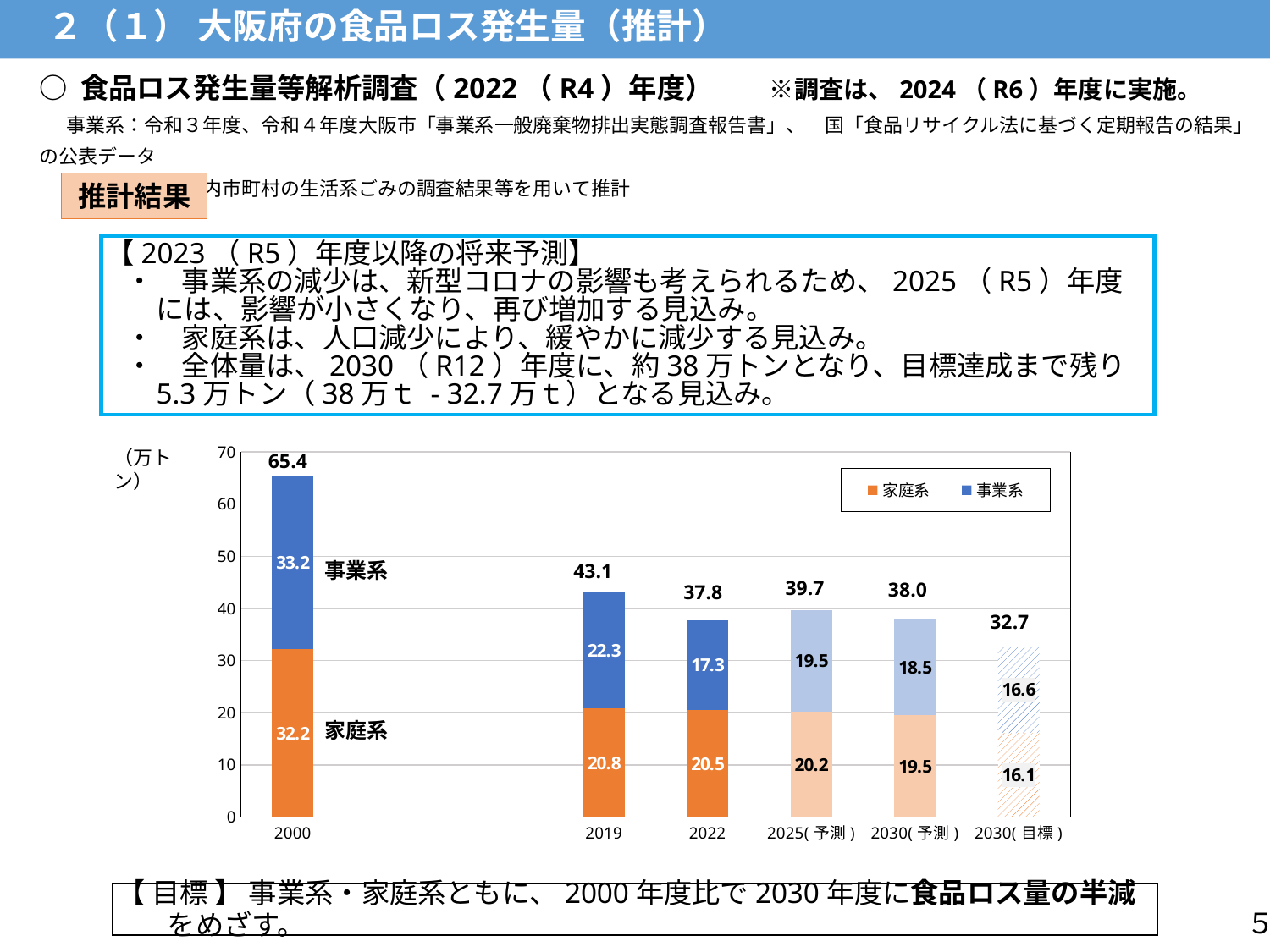
What type of chart is shown on the slide? Stacked bar chart What is the difference between the 事業系 value for 2000 and the 事業系 value for 2019? 10.9 Which category has the lowest total value? 2030(目標) How many categories are shown on the x axis of the chart? 6 Which is larger, the 家庭系 value for 2025(予測) or the 家庭系 value for 2030(予測)? 2025(予測) What is the total of the stacked bar for 2019? 43.1 Which category has the highest total value? 2000 How many series does the chart legend list? 2 What is the value of 事業系 for 2022? 17.3 What is the value of 家庭系 for 2000? 32.2 Which colour represents 家庭系 in the chart legend? Orange What is the total of the stacked bar for 2030(目標)? 32.7